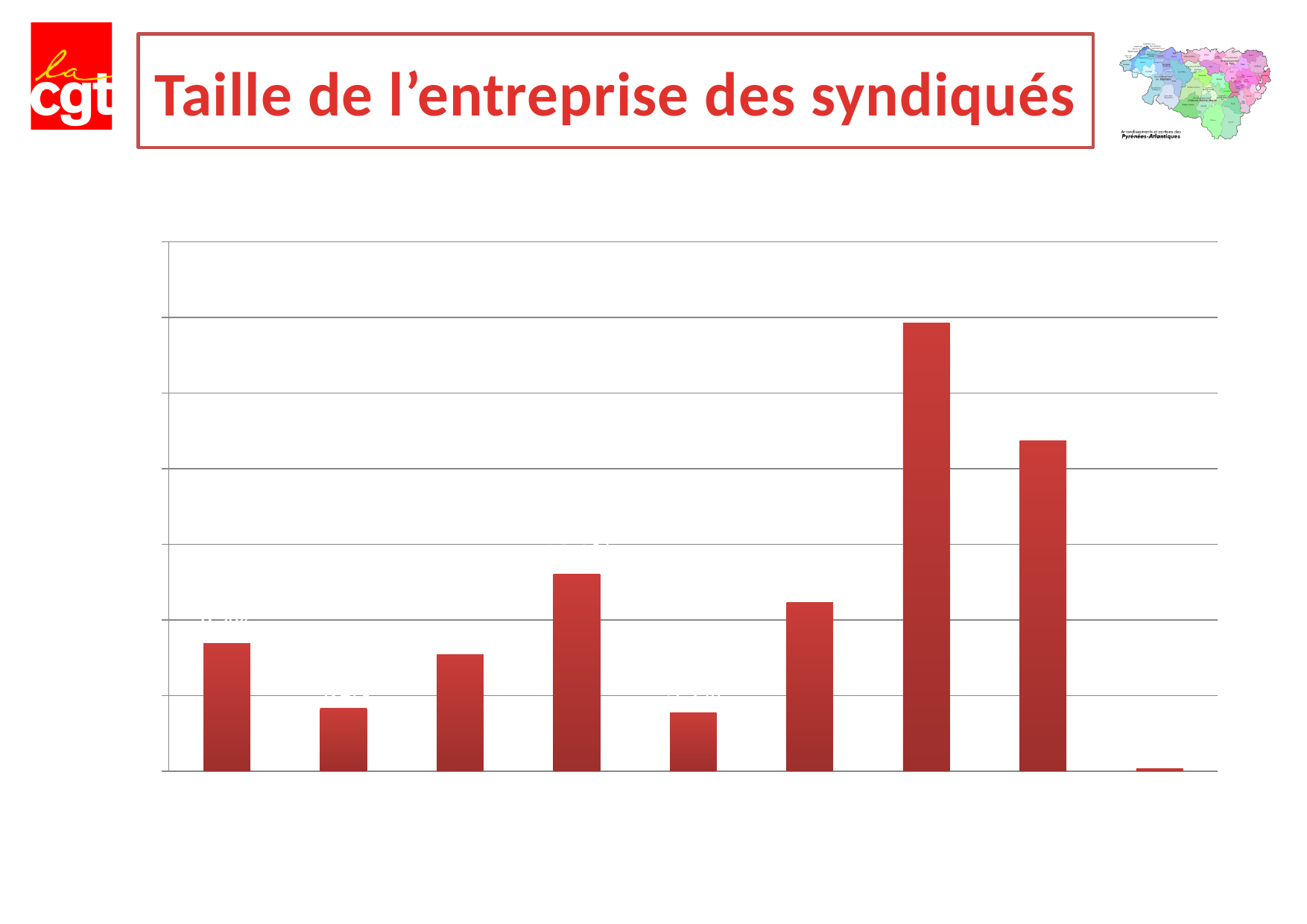
What colour are the bars in the chart? red Counting from the left, which bar is the shortest in the chart? the ninth bar Counting from the left, which bar is the tallest in the chart? the seventh bar How many bars are plotted in the chart? 9 What is the title of the slide containing the chart? Taille de l'entreprise des syndiqués Which is taller, the first bar from the left or the second bar from the left? the first bar Which is taller, the eighth bar from the left or the ninth bar from the left? the eighth bar What kind of chart is shown on the slide? bar chart Which is taller, the fourth bar from the left or the sixth bar from the left? the fourth bar